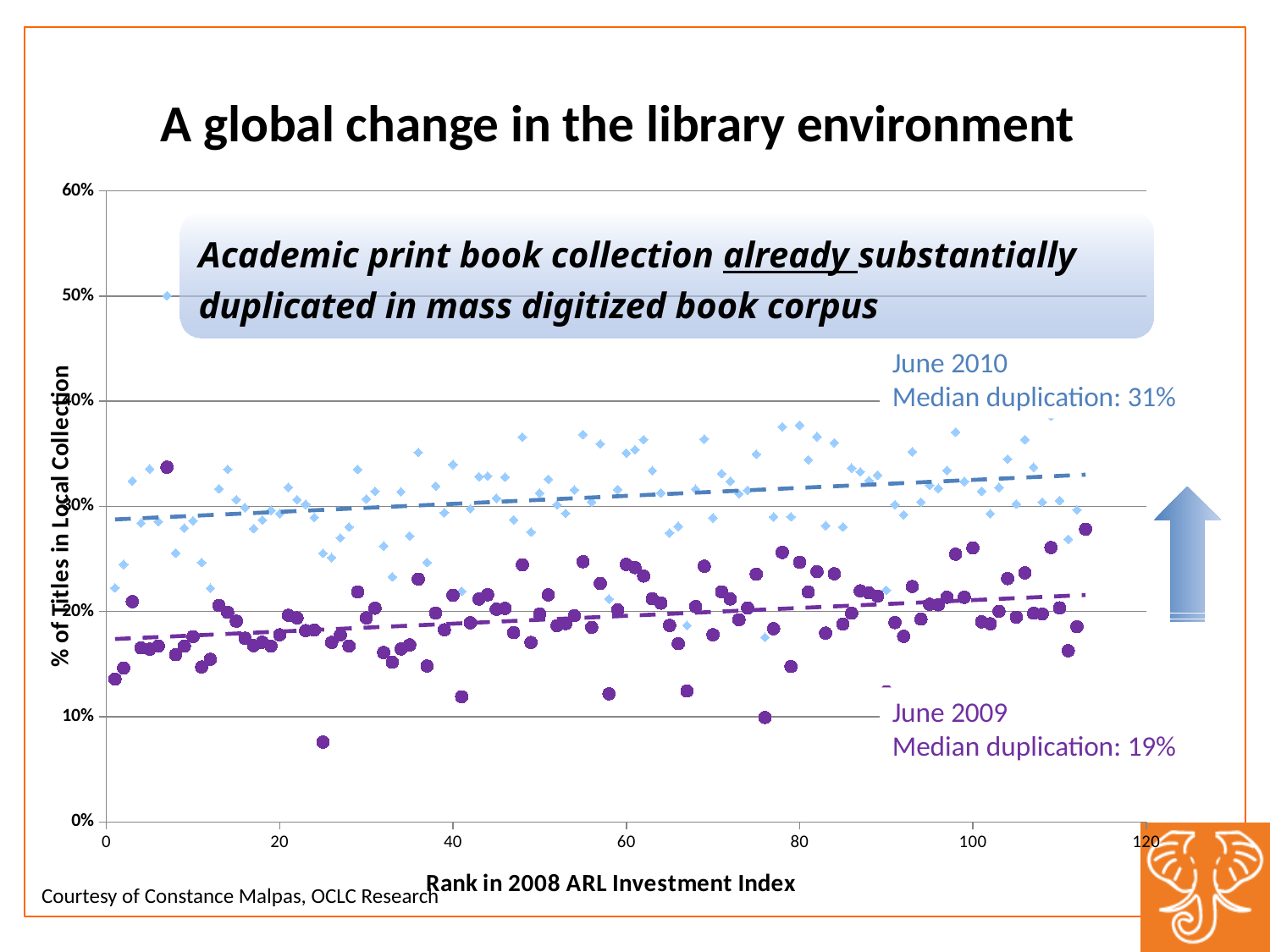
What is the highest value shown on the vertical axis? 60% What is the median duplication for June 2009? 19% What kind of chart is shown on the slide? Scatter chart What is the title of the horizontal axis? Rank in 2008 ARL Investment Index What is the median duplication for June 2010? 31% What is the title of the vertical axis? % of Titles in Local Collection Is the highest June 2010 point on the chart greater or less than 40%? greater Is the lowest June 2009 point on the chart greater or less than 10%? less Do the dashed trend lines rise or fall as rank increases along the x axis? rise Which series has the higher median duplication, June 2010 or June 2009? June 2010 By how many percentage points does the June 2010 median duplication exceed the June 2009 median duplication? 12 percentage points How many data series are plotted on the chart? 2